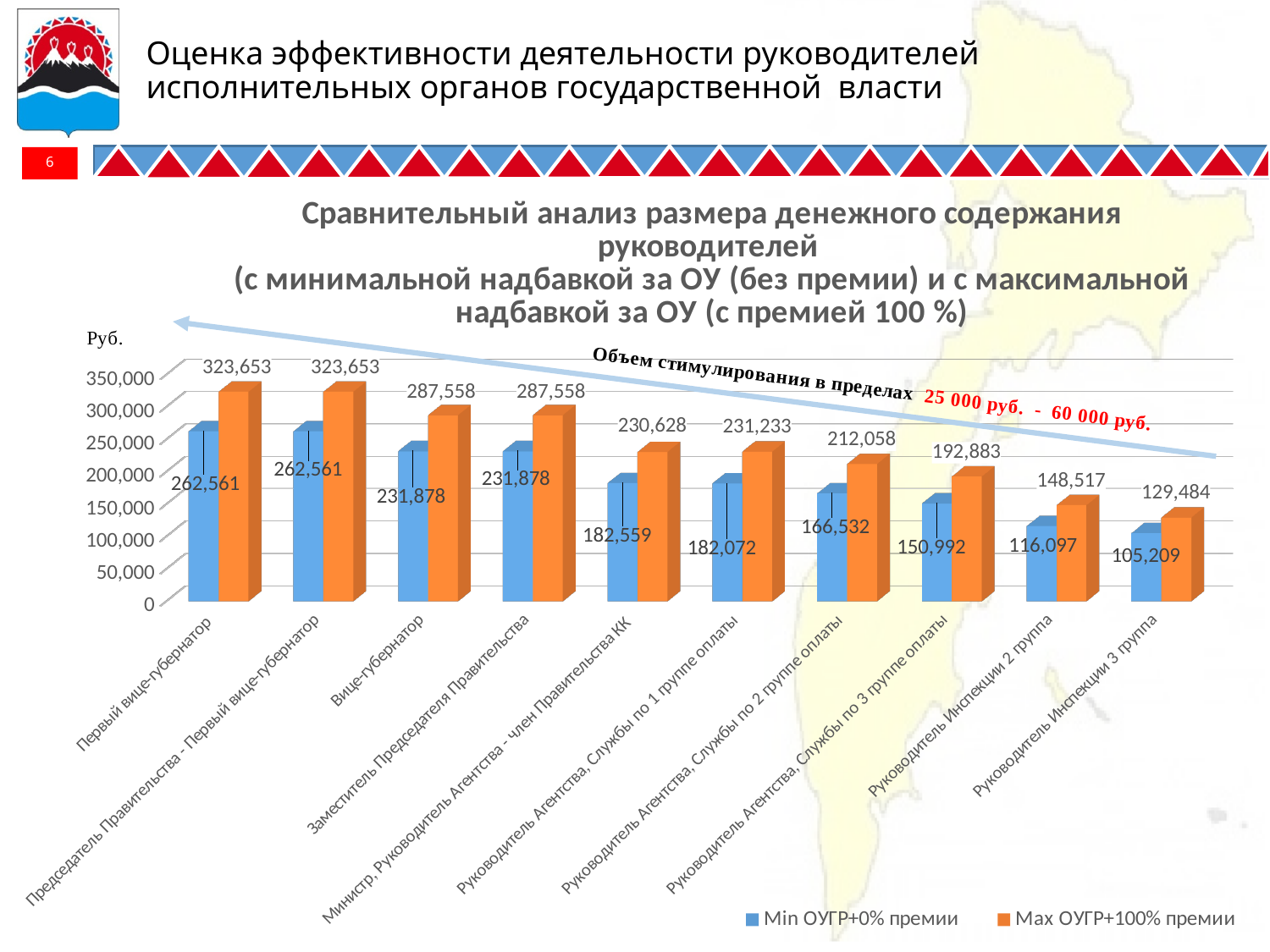
What is the value of the Max ОУГР+100% премии series for Вице-губернатор? 287,558 What kind of chart is shown on the slide? Bar chart Which category has the lowest Min ОУГР+0% премии value? Руководитель Инспекции 3 группа Is the Min ОУГР+0% премии value for Руководитель Агентства, Службы по 2 группе оплаты greater or less than 150,000? greater What is the difference between the Max ОУГР+100% премии and Min ОУГР+0% премии values for Первый вице-губернатор? 61,092 Do the Max ОУГР+100% премии values generally rise or fall from left to right along the x axis? Fall How many categories are shown on the x axis of the chart? 10 Which is larger: the Max ОУГР+100% премии value for Министр, Руководитель Агентства - член Правительства КК or for Руководитель Агентства, Службы по 1 группе оплаты? Руководитель Агентства, Службы по 1 группе оплаты What is the Max ОУГР+100% премии value for Руководитель Агентства, Службы по 3 группе оплаты? 192,883 How many series does the chart legend list? 2 What is the difference between the Max ОУГР+100% премии and Min ОУГР+0% премии values for Руководитель Инспекции 3 группа? 24,275 What is the value of the Min ОУГР+0% премии series for Руководитель Инспекции 2 группа? 116,097